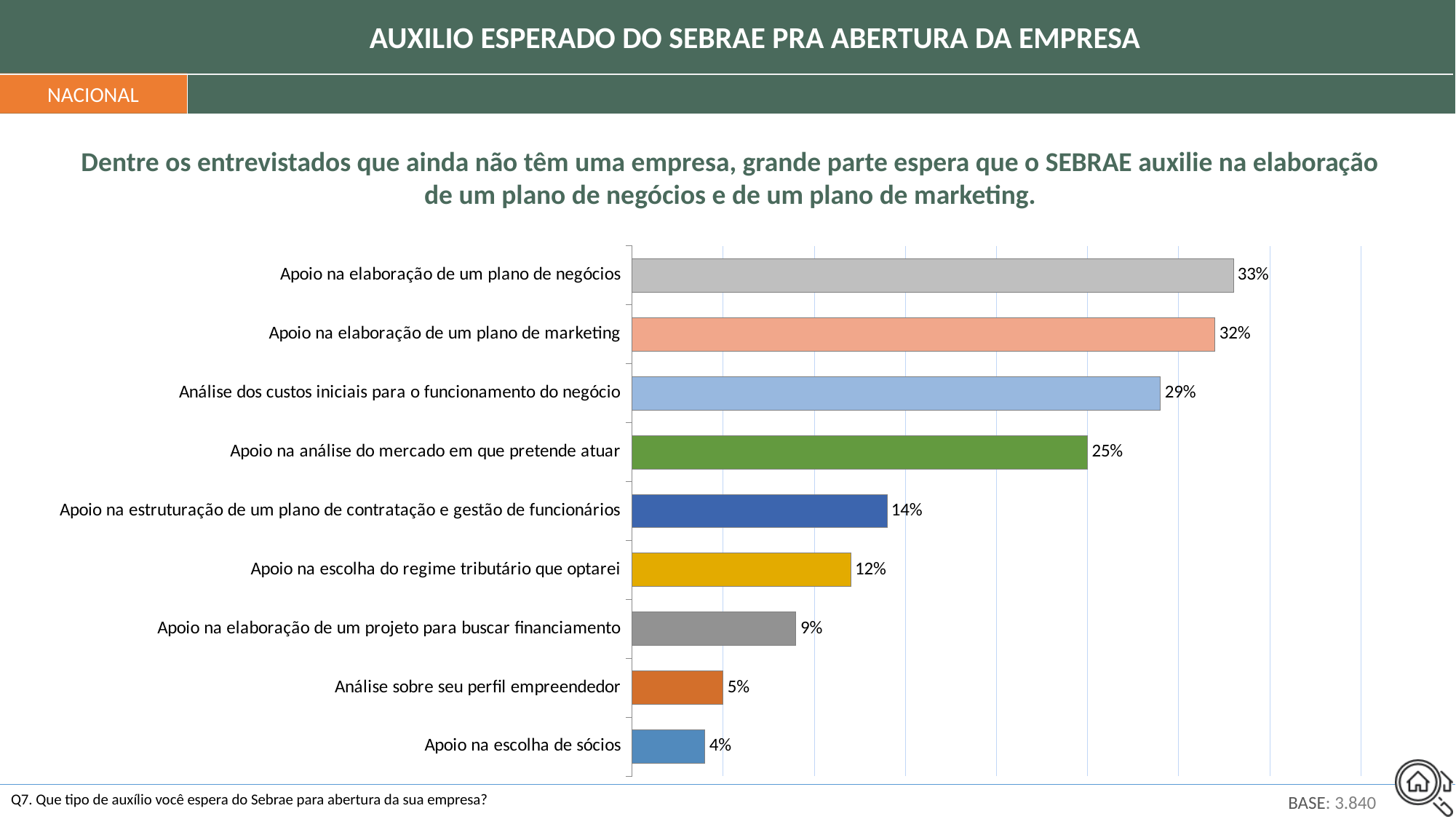
What is the difference between the highest and lowest values in the chart? 29% What kind of chart is shown on the slide? Bar chart What is the value for 'Apoio na elaboração de um plano de marketing'? 32% What is the value for 'Apoio na escolha do regime tributário que optarei'? 12% Which is larger: 'Apoio na elaboração de um projeto para buscar financiamento' or 'Análise sobre seu perfil empreendedor'? Apoio na elaboração de um projeto para buscar financiamento How many categories are shown in the chart? 9 Which category has the lowest value? Apoio na escolha de sócios What is the difference between 'Apoio na análise do mercado em que pretende atuar' and 'Apoio na estruturação de um plano de contratação e gestão de funcionários'? 11% Which category has the highest value? Apoio na elaboração de um plano de negócios What percentage of respondents expect support in preparing a business plan (Apoio na elaboração de um plano de negócios)? 33% What is the base (number of respondents) shown on the slide? 3.840 What is the value for 'Análise dos custos iniciais para o funcionamento do negócio'? 29%